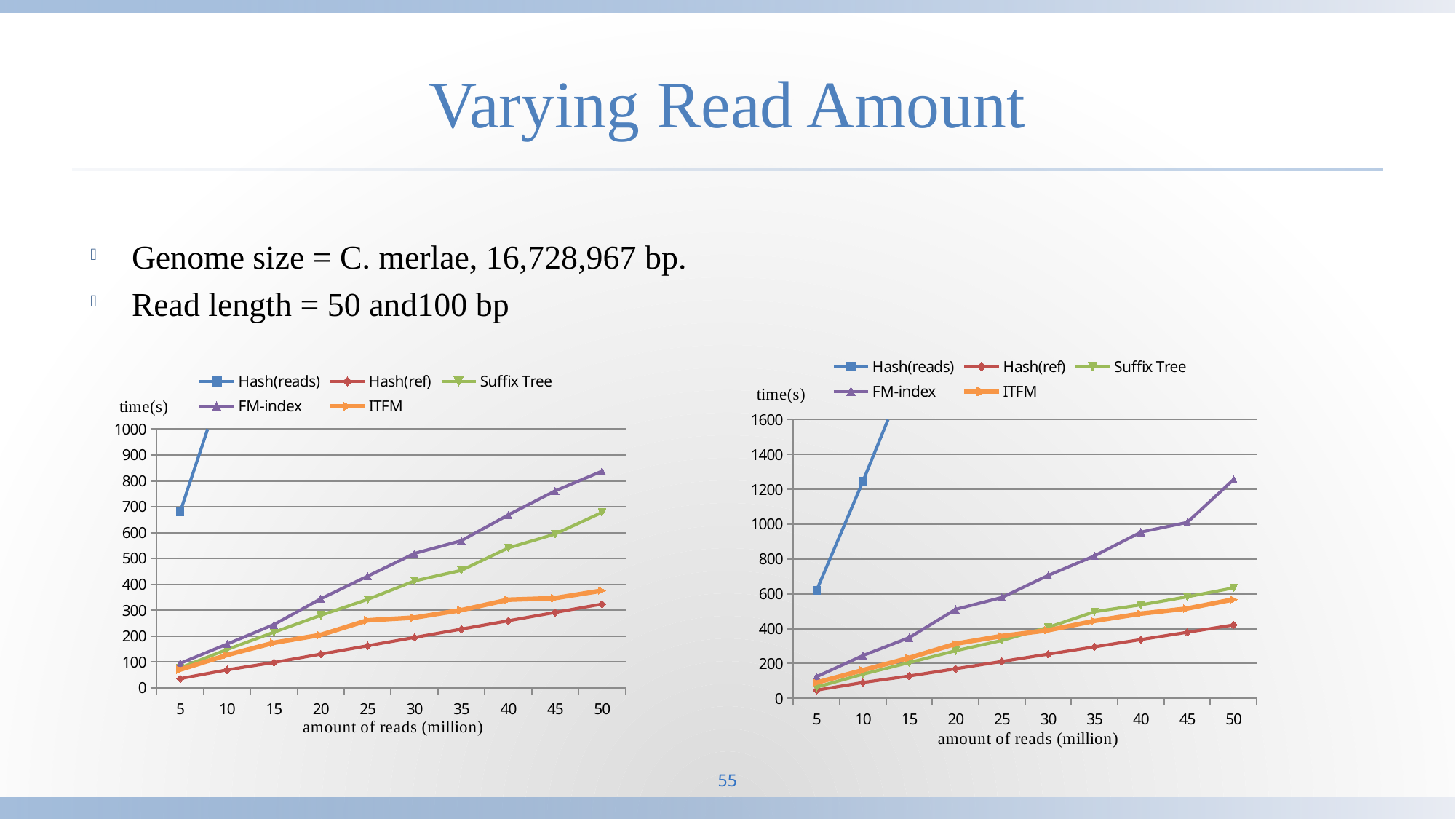
In the right chart, does the Hash(ref) series rise or fall as the amount of reads increases? rise What kind of chart is the left chart? line chart In the left chart, which series has the lowest value at 50 million reads? Hash(ref) In the left chart, which is larger at 40 million reads, FM-index or Suffix Tree? FM-index How many series does the legend of the right chart list? 5 What is the x-axis label of the right chart? amount of reads (million) How many x-axis categories (amounts of reads) are shown on the left chart? 10 In the left chart, is the value for Suffix Tree at 50 million reads greater or less than 700? less In the right chart, which is larger at 50 million reads, Suffix Tree or ITFM? Suffix Tree In the right chart, is the value for FM-index at 50 million reads greater or less than 1200? greater In the left chart, is the value for FM-index at 50 million reads greater or less than 800? greater